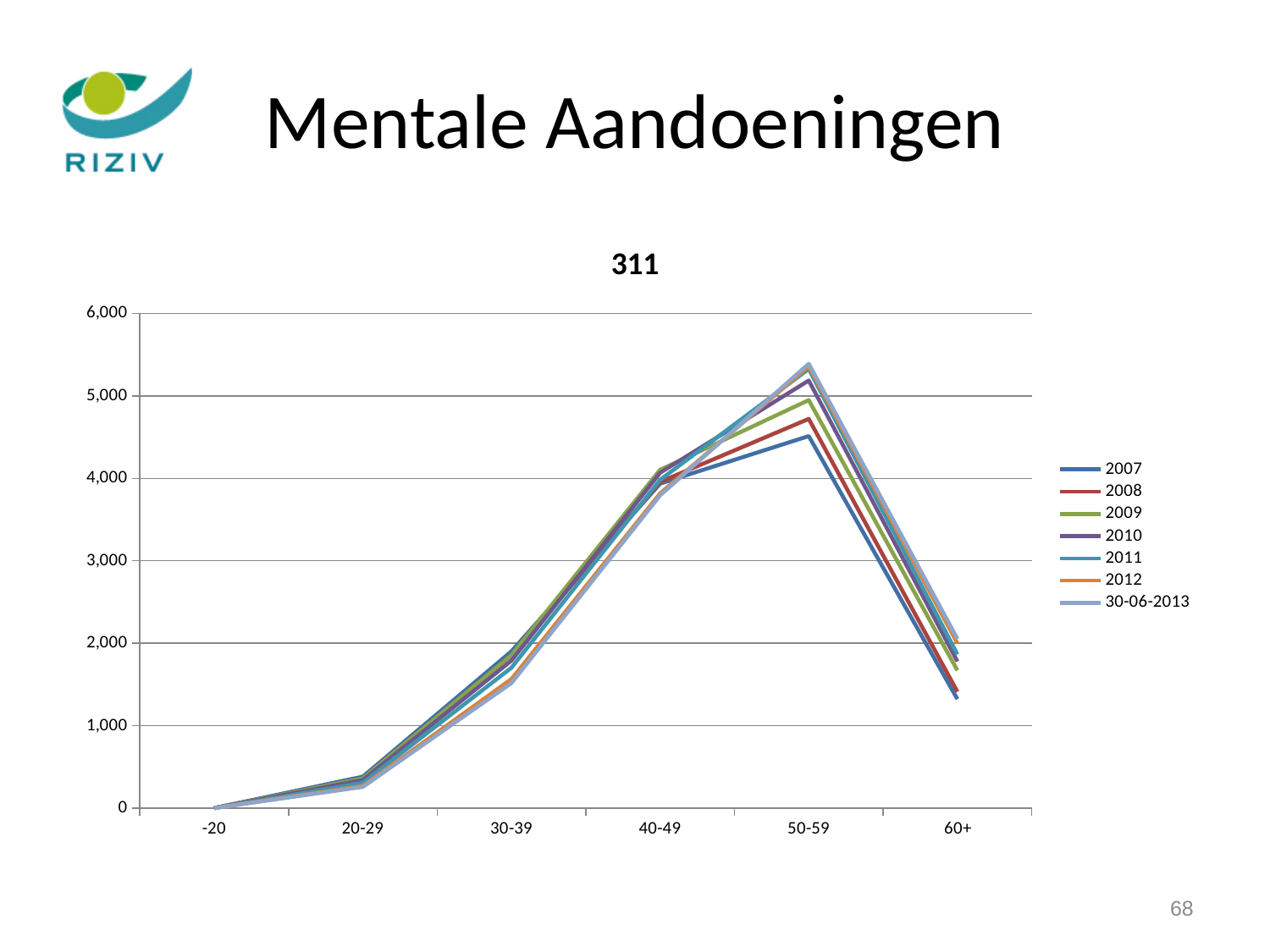
For which age category does the 30-06-2013 series have its lowest value? -20 Is the value for 2007 at 50-59 greater or less than 4,000? greater For which age category does the 2007 series reach its highest value? 50-59 What is the title of the chart? 311 What kind of chart is shown on the slide? line chart Which series is listed last in the legend? 30-06-2013 Is the value for 2007 at 60+ greater or less than 2,000? less How many series does the legend list? 7 Does the 30-06-2013 series rise or fall between 50-59 and 60+? fall At 50-59, which series has the larger value, 2007 or 30-06-2013? 30-06-2013 How many age categories are shown on the x axis? 6 Is the value for 30-06-2013 at 50-59 greater or less than 5,000? greater